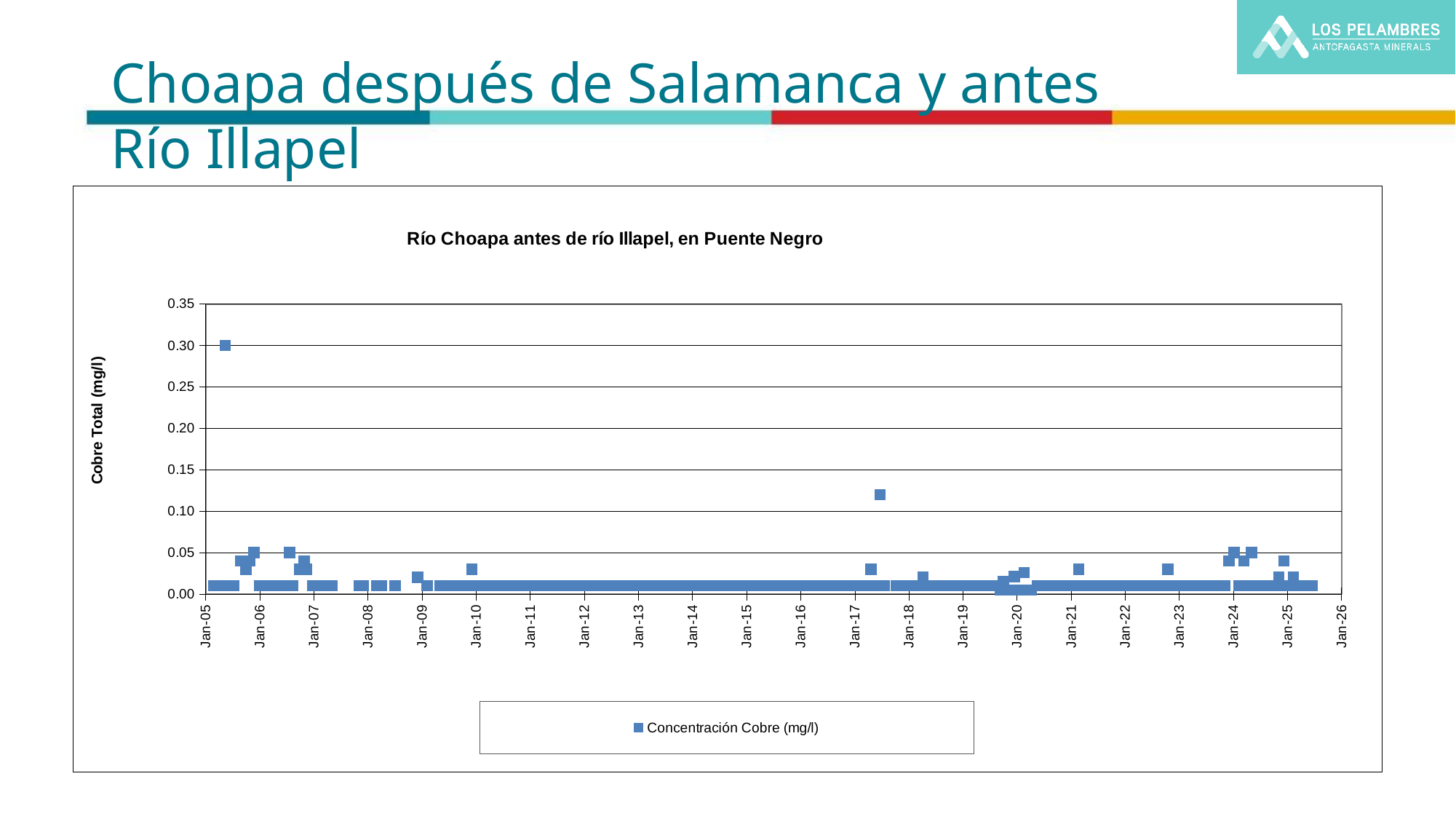
Is the isolated high point plotted in 2017 greater or less than 0.10? greater In which year does the highest plotted value occur? 2005 Are the values plotted in 2015 greater or less than 0.05? less What kind of chart is shown on the slide? scatter chart What is the maximum value shown on the y axis? 0.35 Which is larger: the highest point in 2005 or the highest point in 2017? 2005 Is the highest plotted value greater or less than 0.25? greater How many series does the legend list? 1 What is the title of the chart? Río Choapa antes de río Illapel, en Puente Negro What is the highest value plotted on the chart? 0.30 What is the legend entry for the plotted series? Concentración Cobre (mg/l)